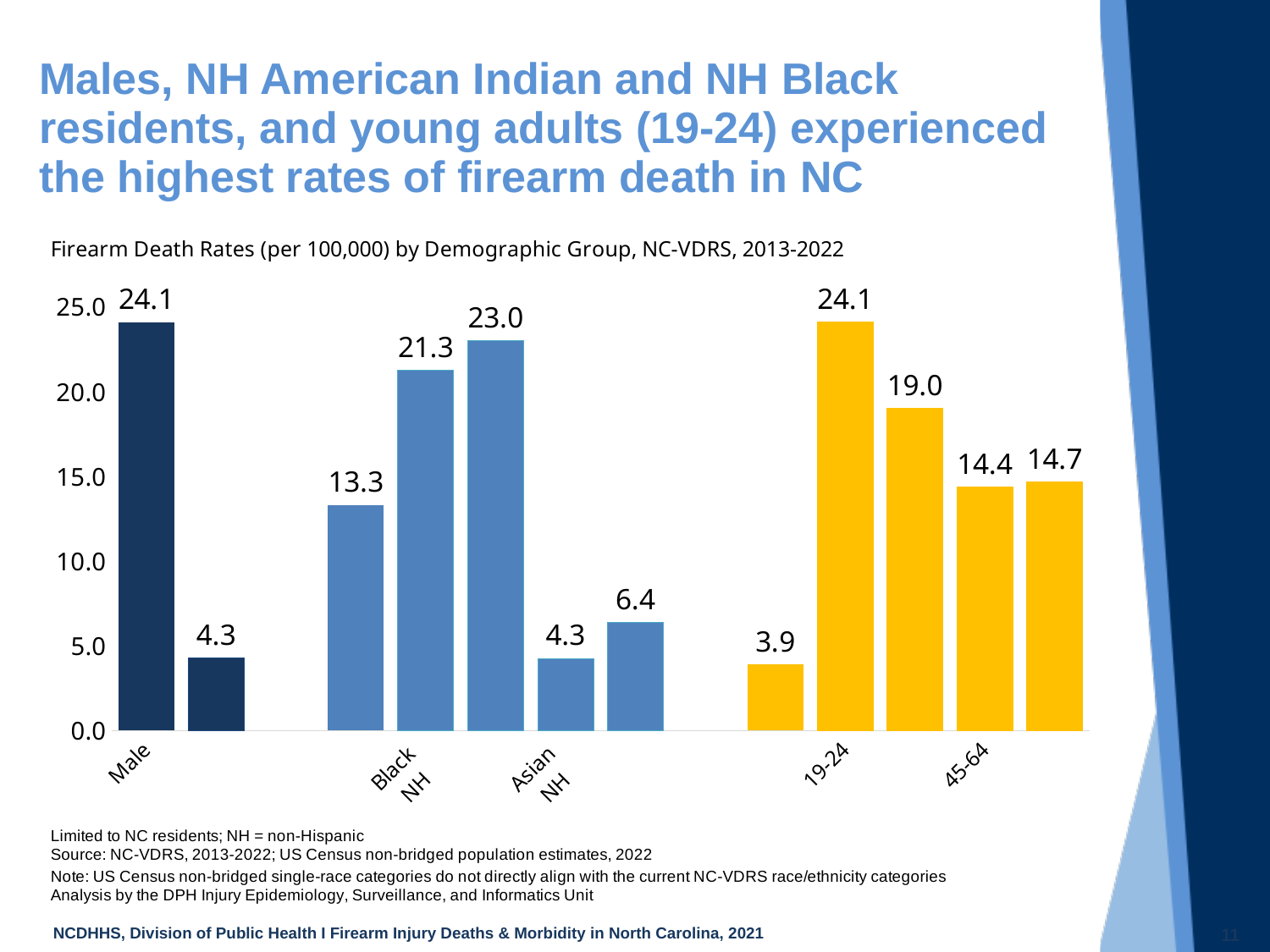
What is the firearm death rate for Asian NH? 4.3 Which has a higher rate, Asian NH or the 45-64 age group? 45-64 Which has a higher rate, Black NH or the 45-64 age group? Black NH What is the firearm death rate for the 19-24 age group? 24.1 What is the title of the chart? Firearm Death Rates (per 100,000) by Demographic Group, NC-VDRS, 2013-2022 What is the difference between the rates for Black NH and Asian NH? 17.0 What is the firearm death rate for Male? 24.1 What is the firearm death rate for the 45-64 age group? 14.4 Is the value for the 45-64 age group greater or less than 10.0? greater What kind of chart is shown on the slide? bar chart What is the difference between the rates for Male and the 45-64 age group? 9.7 What is the firearm death rate for Black NH? 21.3